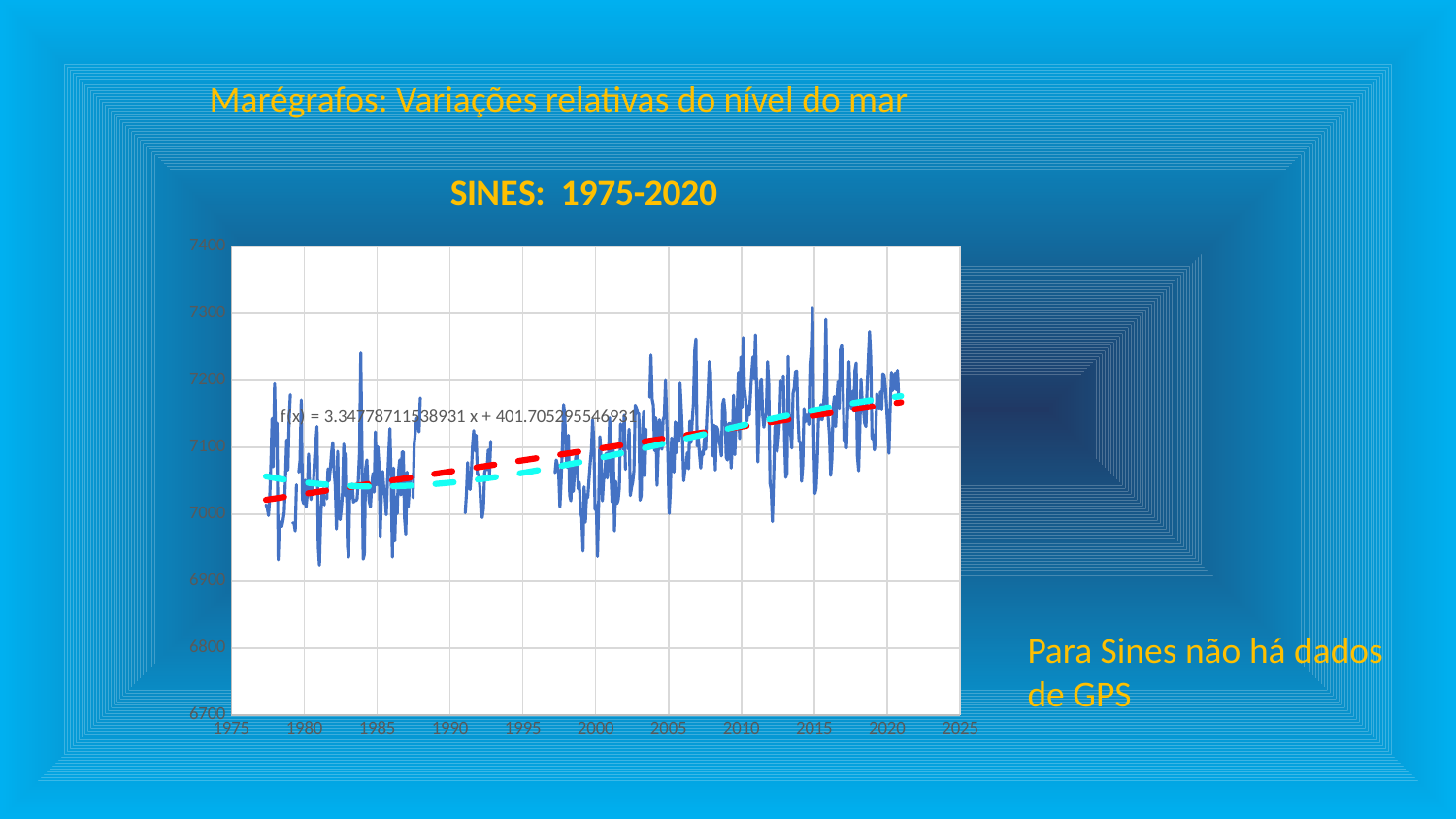
Is the lowest dip of the blue line, around 1983, greater or less than 7000? less Is the red dashed trend line at its start, around 1978, greater or less than 7100? less Is the highest peak of the blue line, around 2015, greater or less than 7200? greater What kind of chart is shown on the slide? line chart What is the slope (coefficient of x) in the trend line equation shown on the chart? 3.34778711538931 What is the lowest value labelled on the vertical axis? 6700 Is the blue line's value at the start of the series, around 1978, higher or lower than its value at the end, around 2020? lower What is the title of the chart? SINES: 1975-2020 How many year labels are shown on the horizontal axis? 11 What is the intercept in the trend line equation shown on the chart? 401.705295546931 Do the sea level values generally rise or fall from 1975 to 2020? rise